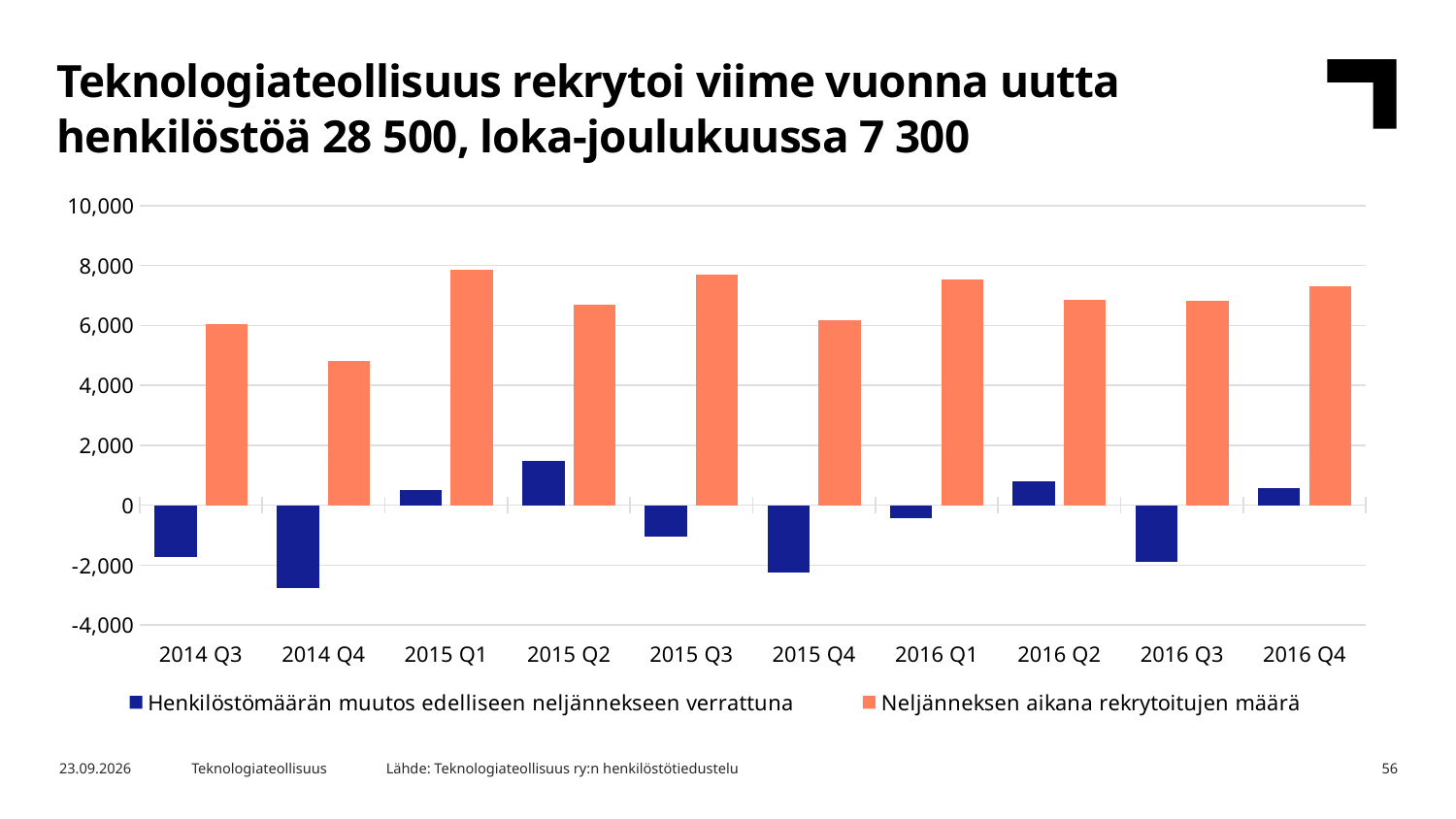
Which quarter has the lowest value for 'Neljänneksen aikana rekrytoitujen määrä'? 2014 Q4 How many series does the chart's legend list? 2 Which is larger, the 'Neljänneksen aikana rekrytoitujen määrä' value for 2014 Q3 or for 2014 Q4? 2014 Q3 What kind of chart is shown on the slide? bar chart What colour are the bars for 'Neljänneksen aikana rekrytoitujen määrä'? orange Is the value for 'Neljänneksen aikana rekrytoitujen määrä' in 2015 Q1 greater or less than 6,000? greater How many quarters are shown on the x axis of the chart? 10 Is the value for 'Neljänneksen aikana rekrytoitujen määrä' in 2014 Q4 greater or less than 6,000? less Which quarter has the highest value for 'Henkilöstömäärän muutos edelliseen neljännekseen verrattuna'? 2015 Q2 Is the value for 'Henkilöstömäärän muutos edelliseen neljännekseen verrattuna' in 2014 Q4 greater or less than -2,000? less Which quarter has the lowest value for 'Henkilöstömäärän muutos edelliseen neljännekseen verrattuna'? 2014 Q4 Which is larger, the 'Neljänneksen aikana rekrytoitujen määrä' value for 2015 Q1 or for 2015 Q2? 2015 Q1